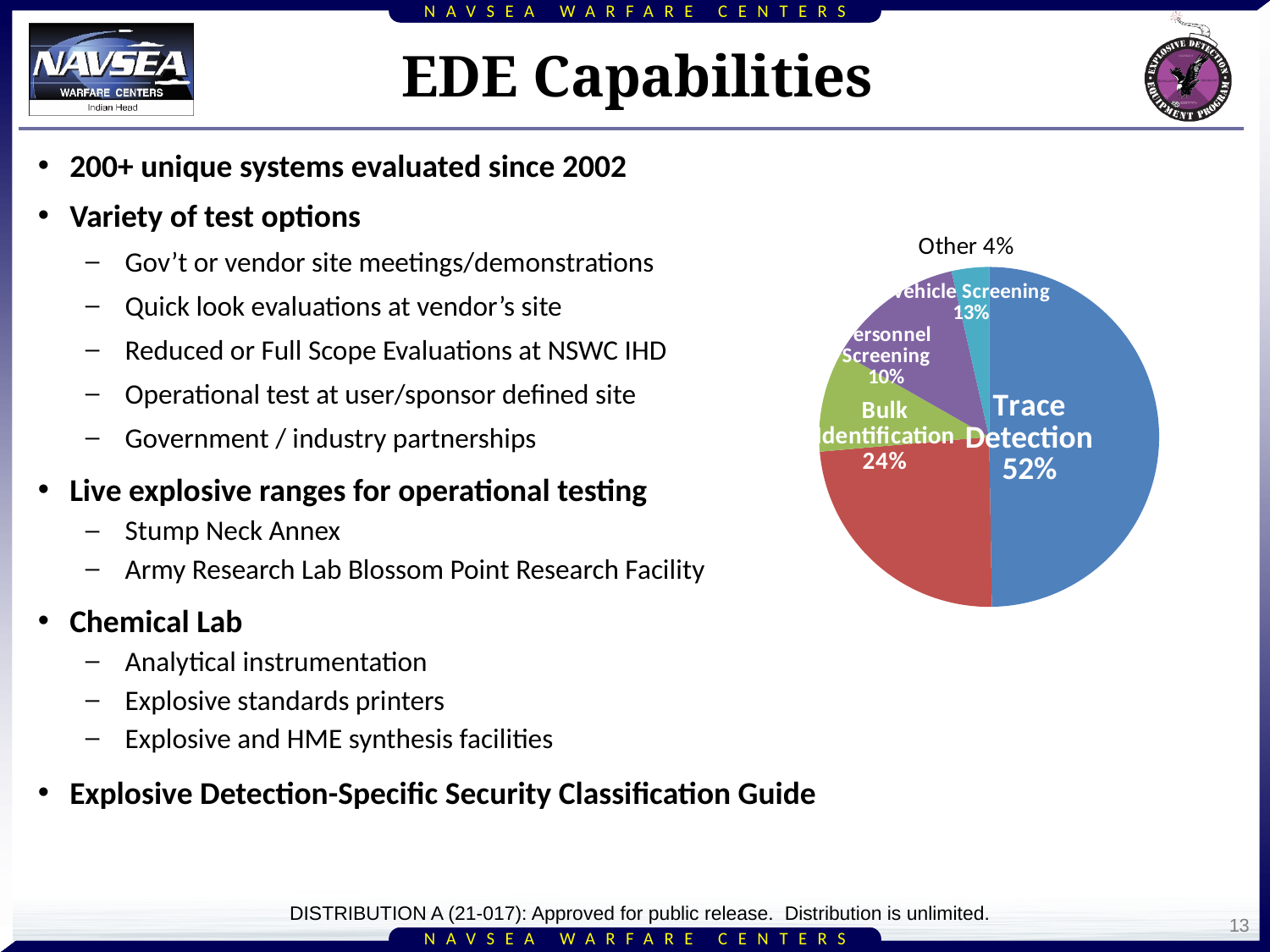
What share of the pie does Personnel Screening represent? 10% What kind of chart is shown on the slide? pie chart What is the difference in percentage points between Trace Detection and Bulk Identification? 28 What colour is the Trace Detection slice? blue What share of the pie does the Other slice represent? 4% What share of the pie does Bulk Identification represent? 24% Which slice of the pie chart is the largest? Trace Detection Which is larger, Vehicle Screening or Personnel Screening? Vehicle Screening How many slices does the pie chart have? 5 Which slice of the pie chart is the smallest? Other